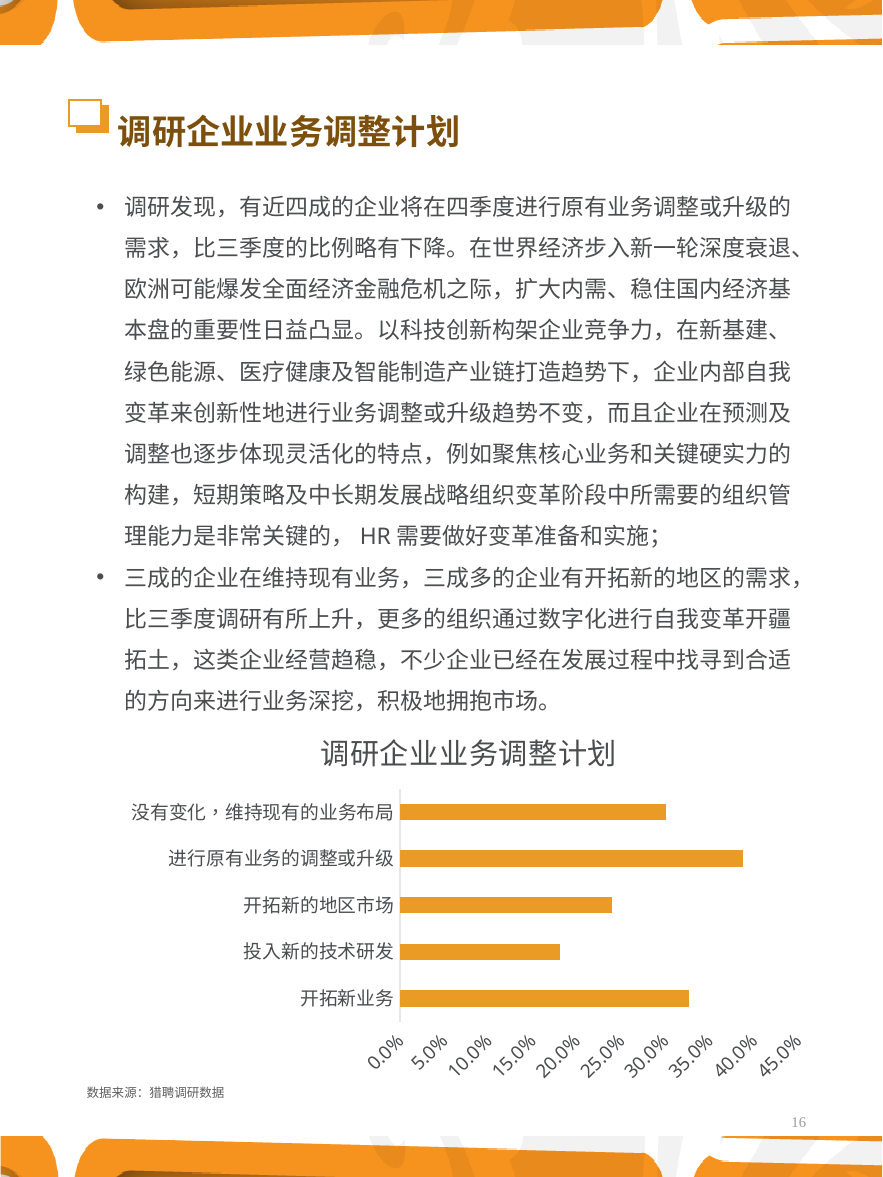
Which is larger, the value for 没有变化，维持现有的业务布局 or the value for 投入新的技术研发? 没有变化，维持现有的业务布局 Is the value for 投入新的技术研发 greater or less than 20.0%? less Which category has the lowest value? 投入新的技术研发 Which is larger, the value for 开拓新业务 or the value for 开拓新的地区市场? 开拓新业务 Is the value for 开拓新业务 greater or less than 30.0%? greater What kind of chart is shown on the slide? bar chart How many categories does the chart show? 5 Which category has the highest value? 进行原有业务的调整或升级 What is the highest value shown on the chart's axis? 45.0% Is the value for 开拓新的地区市场 greater or less than 30.0%? less What is the title of the chart? 调研企业业务调整计划